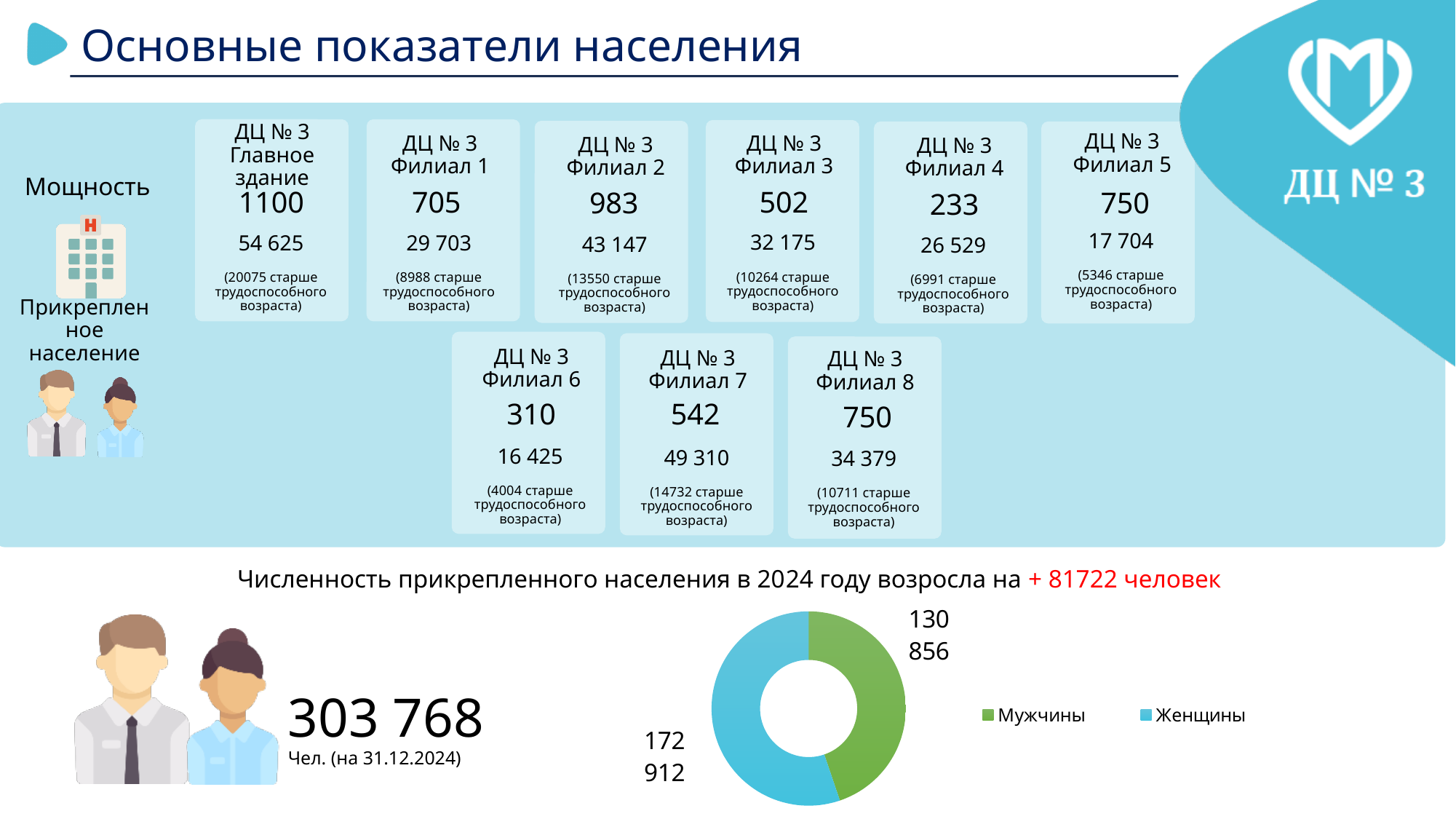
What is the value for Женщины in the donut chart? 172 912 In the donut chart, is the value for Женщины larger or smaller than the value for Мужчины? larger What kind of chart is shown at the bottom of the slide? Donut (pie) chart What is the difference between the Женщины and Мужчины values in the donut chart? 42 056 Which category has the largest slice in the donut chart? Женщины What share of the donut chart does Женщины represent, rounded to one decimal place? 56.9% How many series does the legend of the donut chart list? 2 What is the value for Мужчины in the donut chart? 130 856 How many slices does the donut chart have? 2 What is the total of the two slices in the donut chart? 303 768 What colour is the Мужчины slice in the donut chart? Green Which category has the smallest slice in the donut chart? Мужчины